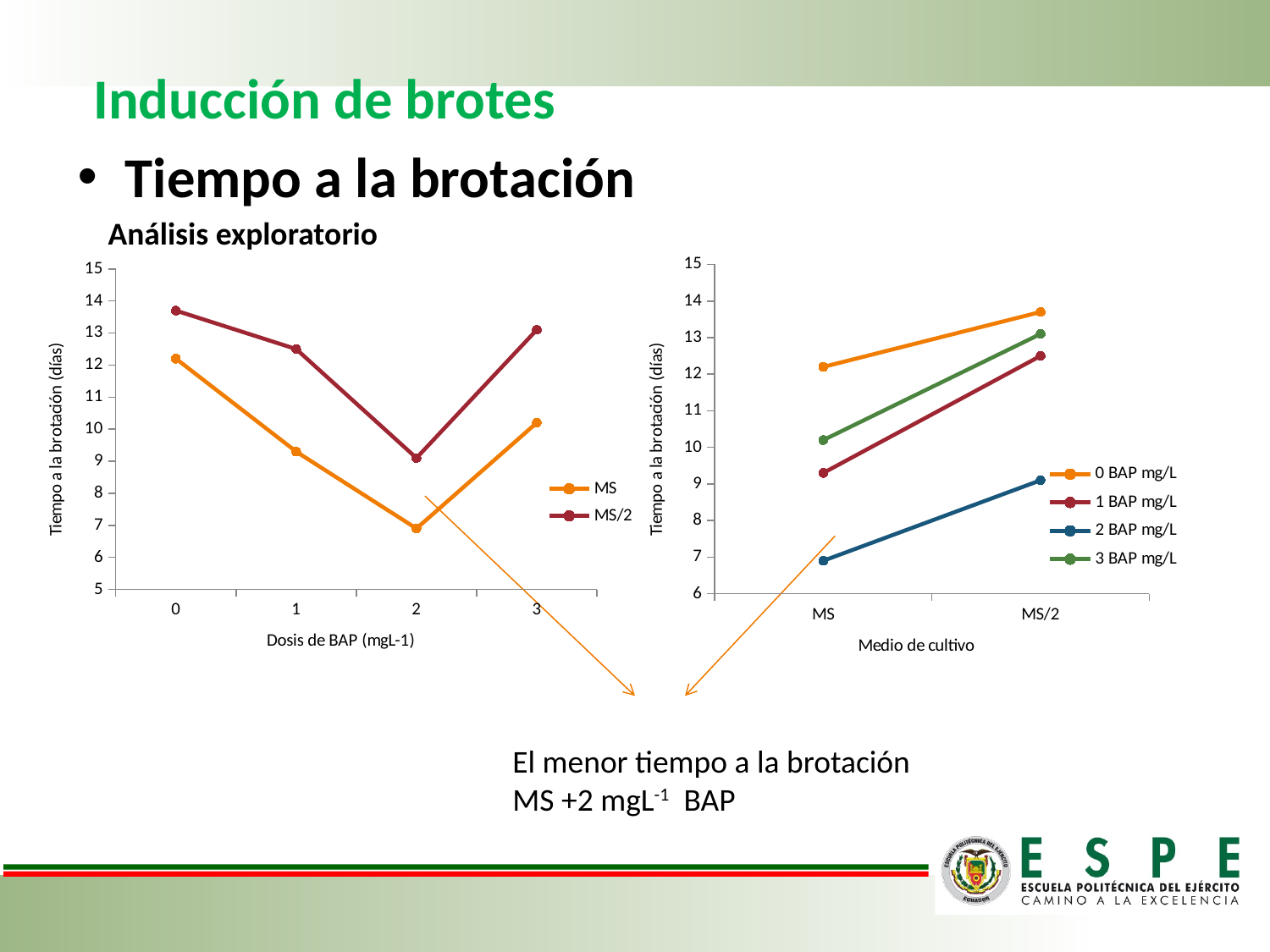
In the left chart, is the MS/2 value at dose 0 greater or less than 13? greater In the left chart, at which BAP dose is the MS series lowest? 2 What kind of chart is the left chart (Dosis de BAP)? line chart How many series does the legend of the left chart list? 2 In the right chart, which series has the lowest value at MS? 2 BAP mg/L What is the x-axis title of the right chart? Medio de cultivo In the left chart, is the MS value at dose 2 greater or less than 8? less In the left chart, which series has the larger value at dose 1, MS or MS/2? MS/2 In the right chart, is the 0 BAP mg/L value at MS/2 greater or less than 13? greater How many BAP dose levels are plotted along the x axis of the left chart? 4 How many series does the legend of the right chart (Medio de cultivo) list? 4 In the right chart, does the 2 BAP mg/L series rise or fall from MS to MS/2? rises